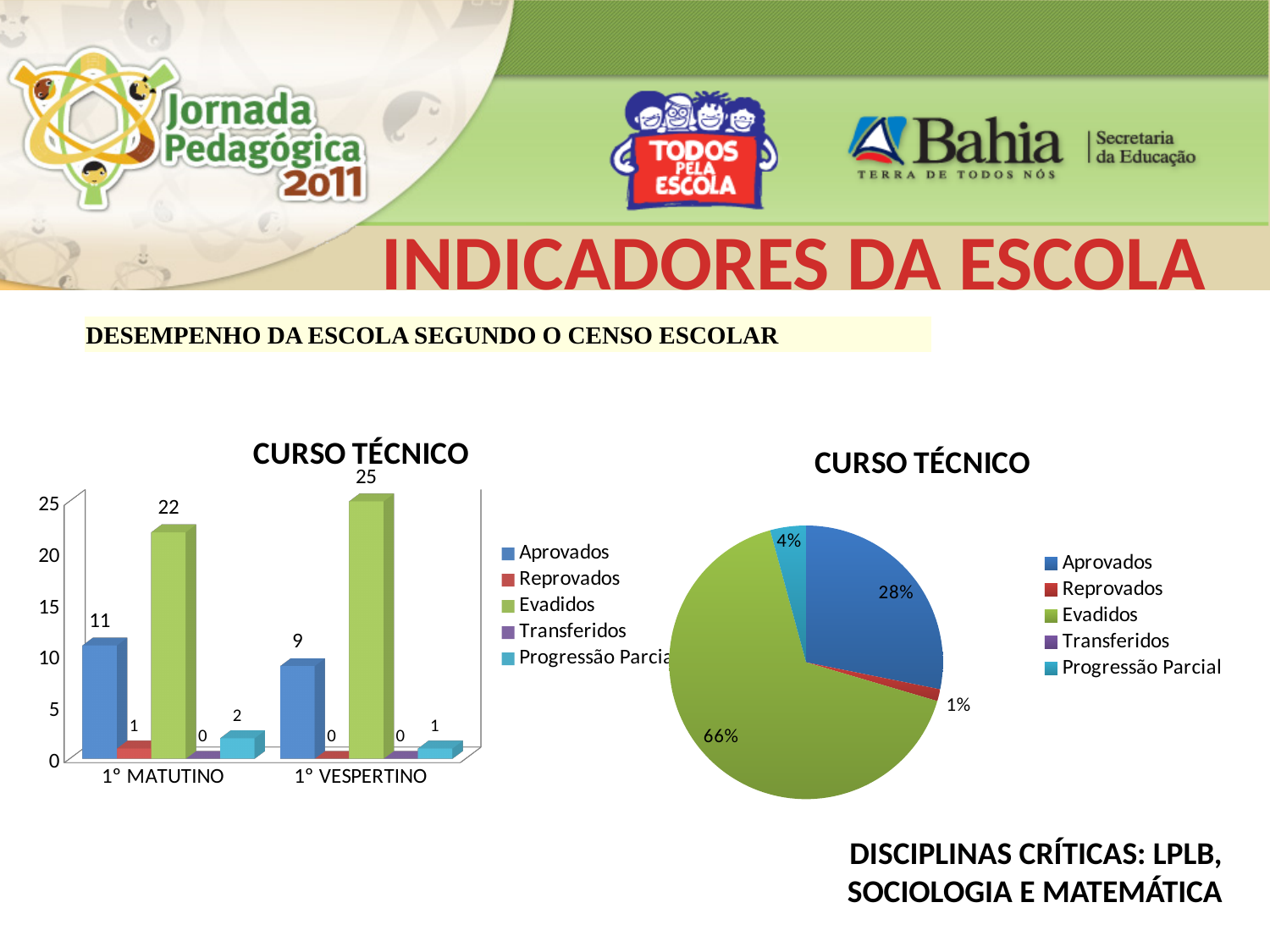
In the bar chart on the left, which series has the highest value in 1° VESPERTINO? Evadidos How many series does the legend of the bar chart on the left list? 5 In the bar chart on the left, what is the value for Evadidos in 1° MATUTINO? 22 What kind of chart is the chart on the right? Pie chart In the pie chart on the right, which slice is the largest? Evadidos In the bar chart on the left, what is the difference between Evadidos in 1° VESPERTINO and Evadidos in 1° MATUTINO? 3 In the bar chart on the left, which is larger: Aprovados in 1° MATUTINO or Aprovados in 1° VESPERTINO? 1° MATUTINO In the bar chart on the left, what is the value for Progressão Parcial in 1° MATUTINO? 2 In the bar chart on the left, what is the value for Aprovados in 1° VESPERTINO? 9 How many categories are shown on the x axis of the bar chart on the left? 2 In the pie chart on the right, what share does Evadidos have? 66% In the pie chart on the right, what share does Aprovados have? 28%